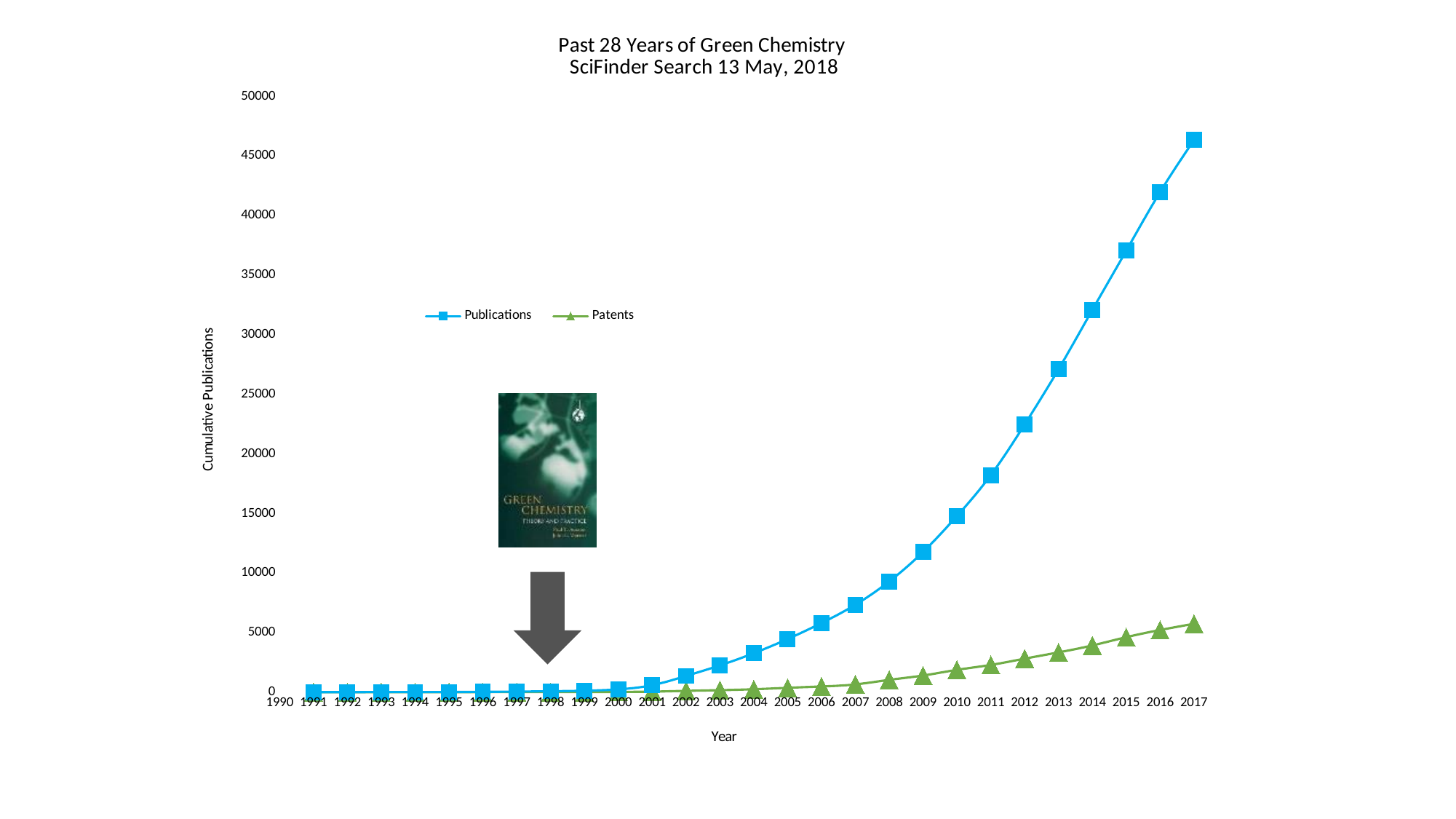
Is the Publications value for 2016 greater or less than 40000? greater Is the Publications value for 2013 greater or less than 25000? greater Do the Publications values rise or fall from 1991 to 2017? rise Is the Publications value for 2011 greater or less than 20000? less How many series does the legend list? 2 Which series has the higher value in 2017, Publications or Patents? Publications What is the label on the vertical axis? Cumulative Publications What kind of chart is shown on the slide? line chart What is the title of the chart? Past 28 Years of Green Chemistry SciFinder Search 13 May, 2018 In which year is the Publications series at its highest? 2017